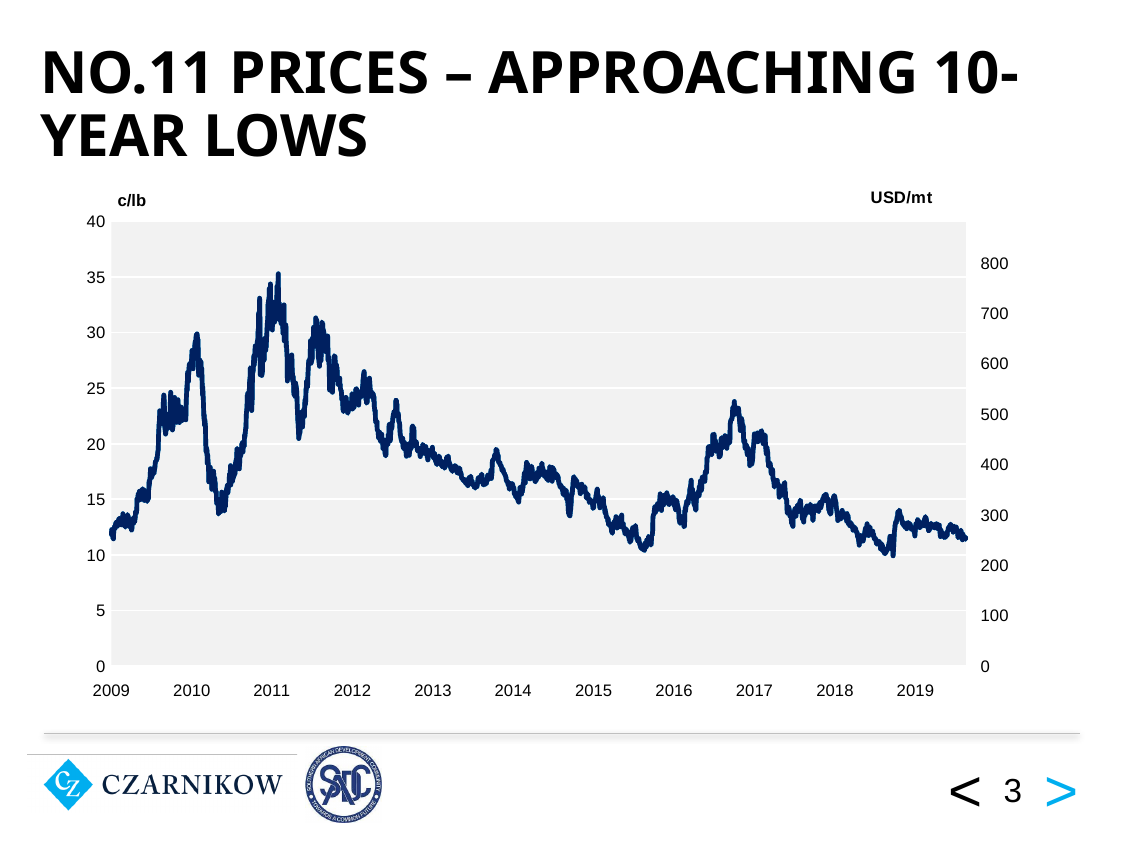
What kind of chart is shown on the slide? line chart Do the values generally rise or fall from 2009 to early 2011? rise Is the peak value reached in late 2016 greater or less than 20 c/lb? greater What units are shown on the left and right vertical axes of the chart? c/lb and USD/mt Is the peak value reached in early 2011 greater or less than 30 c/lb? greater Is the value at the start of 2009 greater or less than 15 c/lb? less Is the peak in late 2016 higher or lower than the peak in early 2011? lower In which year does the line reach its highest value? 2011 How many years are labelled on the x axis? 11 What is the title of the slide containing the chart? NO.11 PRICES – APPROACHING 10-YEAR LOWS Do the values generally rise or fall from the 2011 peak to 2019? fall